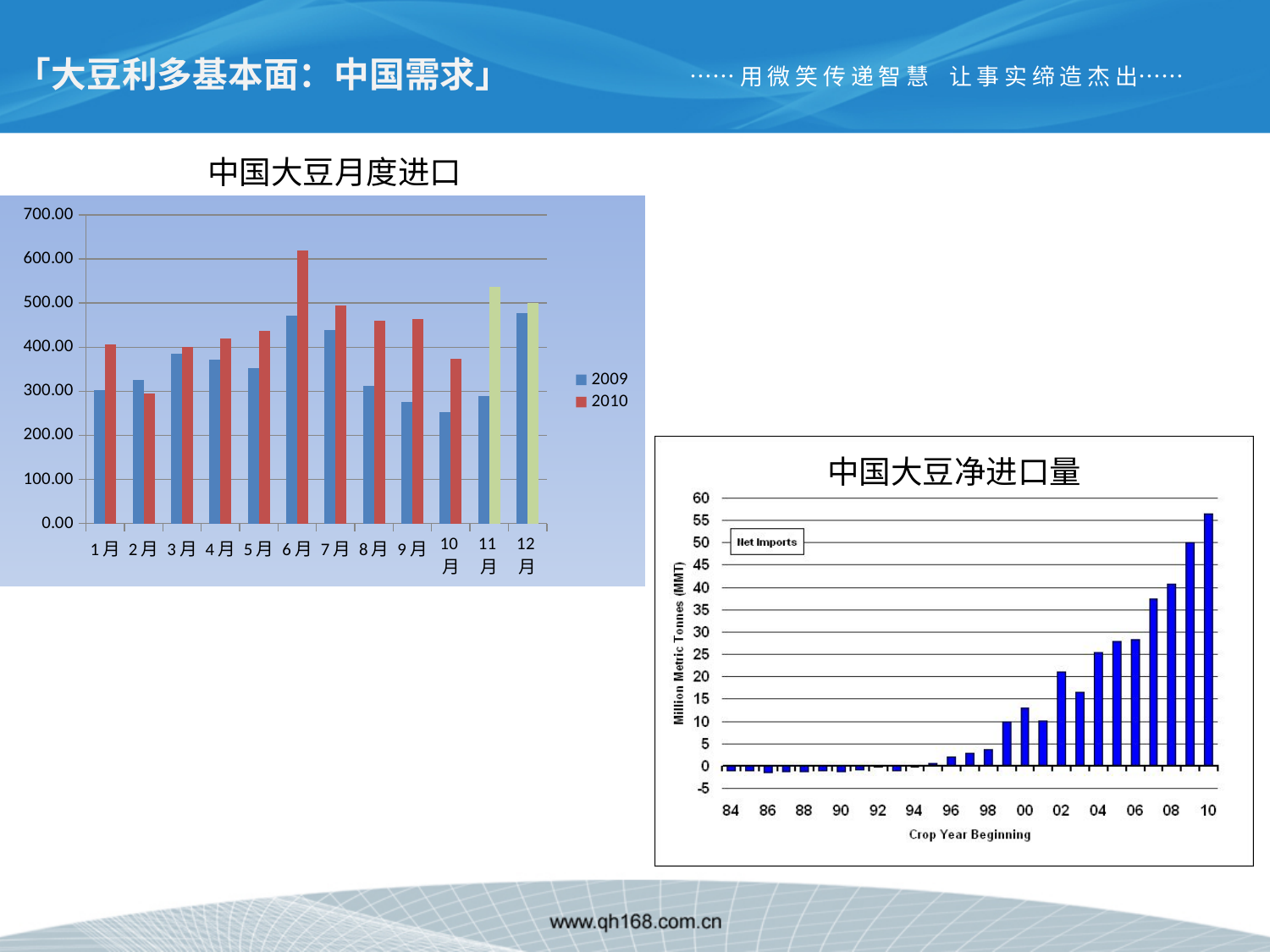
In the 中国大豆月度进口 chart, is the 2010 value for 6月 greater or less than 600.00? greater How many months are shown on the x axis of the 中国大豆月度进口 chart? 12 In the 中国大豆月度进口 chart, which month has the highest 2010 value? 6月 How many series does the legend of the 中国大豆月度进口 chart list? 2 In the 中国大豆净进口量 chart, which crop year has the highest net imports? 10 What kind of chart is the 中国大豆月度进口 chart? bar chart In the 中国大豆月度进口 chart, is the 2009 value for 10月 greater or less than 300.00? less In the 中国大豆净进口量 chart, do net imports generally rise or fall from 84 to 10? rise In the 中国大豆月度进口 chart, which is larger for 1月: the 2009 value or the 2010 value? 2010 What kind of chart is the 中国大豆净进口量 chart? bar chart In the 中国大豆净进口量 chart, is the value for crop year 06 greater or less than 25? greater In the 中国大豆月度进口 chart, which month has the lowest 2009 value? 10月